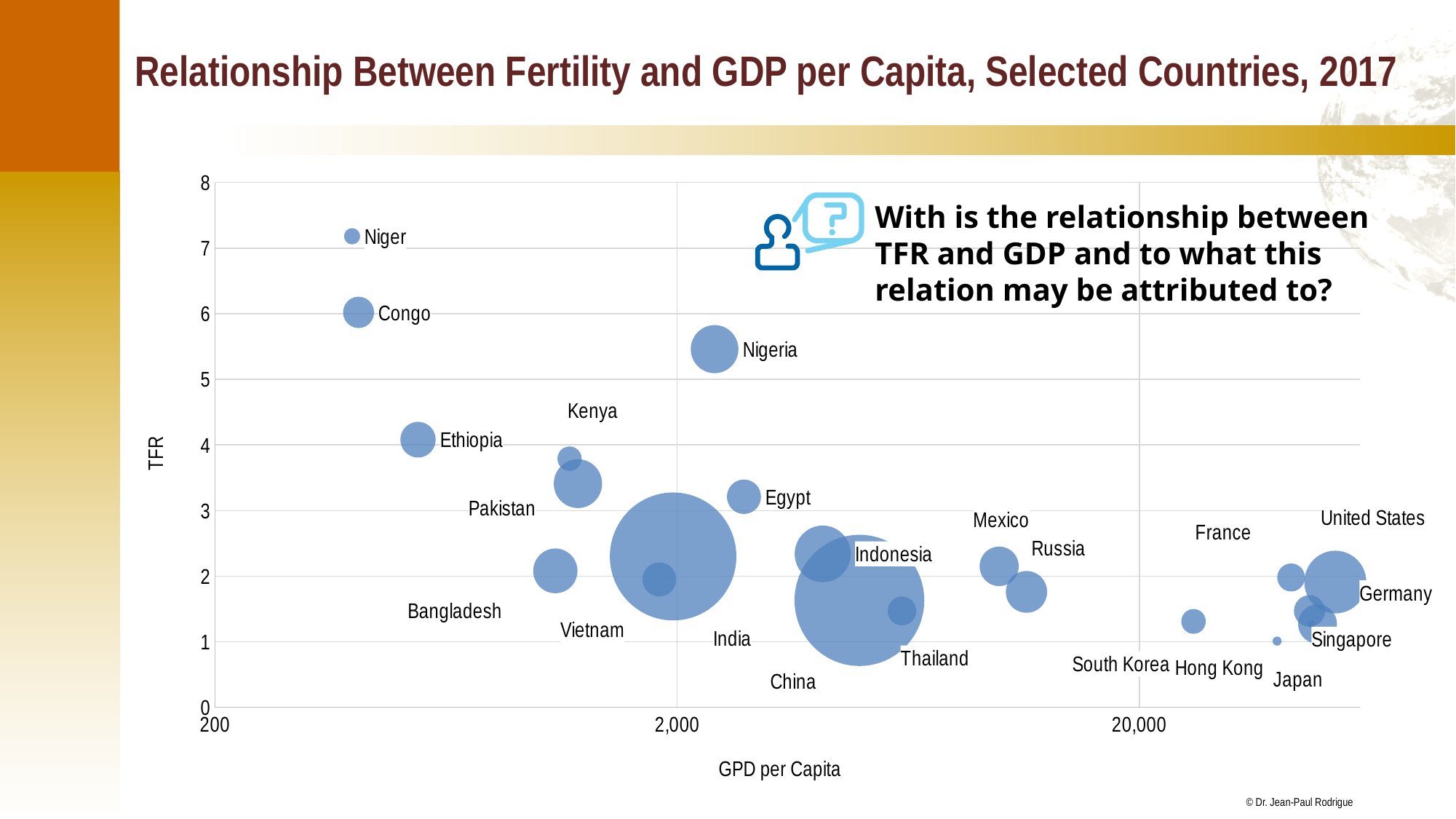
Is the TFR value for Nigeria greater or less than 5? greater Which has a higher TFR, Niger or Congo? Niger Is the TFR value for Japan greater or less than 2? less Which has a higher TFR, Nigeria or Ethiopia? Nigeria Is the TFR value for South Korea greater or less than 2? less Which country has the highest TFR on the chart? Niger What kind of chart is shown on the slide? bubble chart As GDP per capita increases along the x axis, does TFR generally rise or fall? fall What is the label of the vertical axis? TFR Which country has the lowest TFR on the chart? Japan